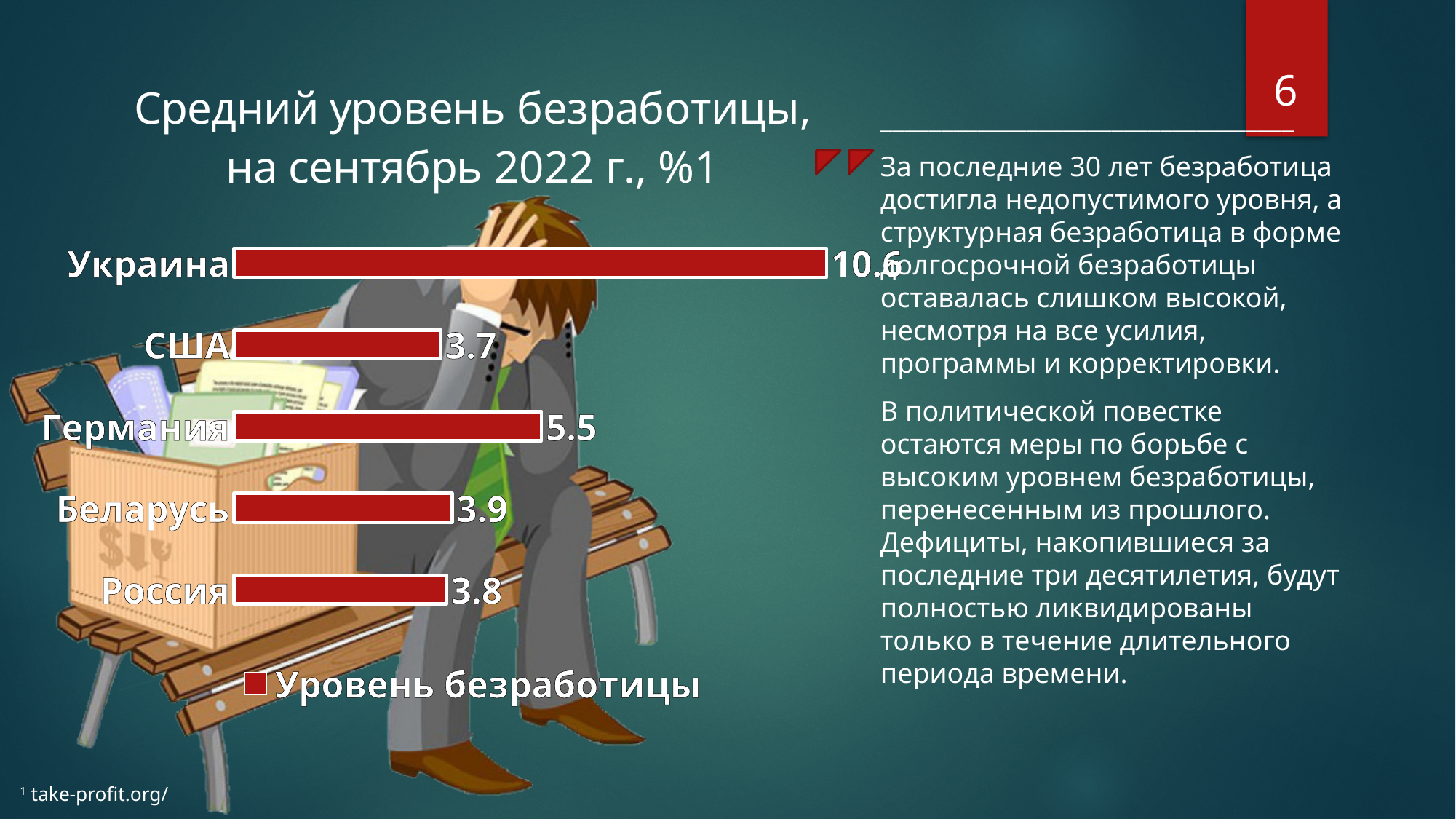
What kind of chart is shown on the slide? Bar chart Which country has the highest unemployment rate on the chart? Украина How many countries are shown on the chart? 5 What is the unemployment rate shown for Украина? 10.6 What is the unemployment rate shown for Беларусь? 3.9 Which has a higher unemployment rate, Германия or Беларусь? Германия What is the legend entry of the chart? Уровень безработицы What is the difference between the unemployment rates of Украина and Германия? 5.1 What is the unemployment rate shown for Россия? 3.8 How many series does the legend list? 1 Which country has the lowest unemployment rate on the chart? США What is the unemployment rate shown for Германия? 5.5